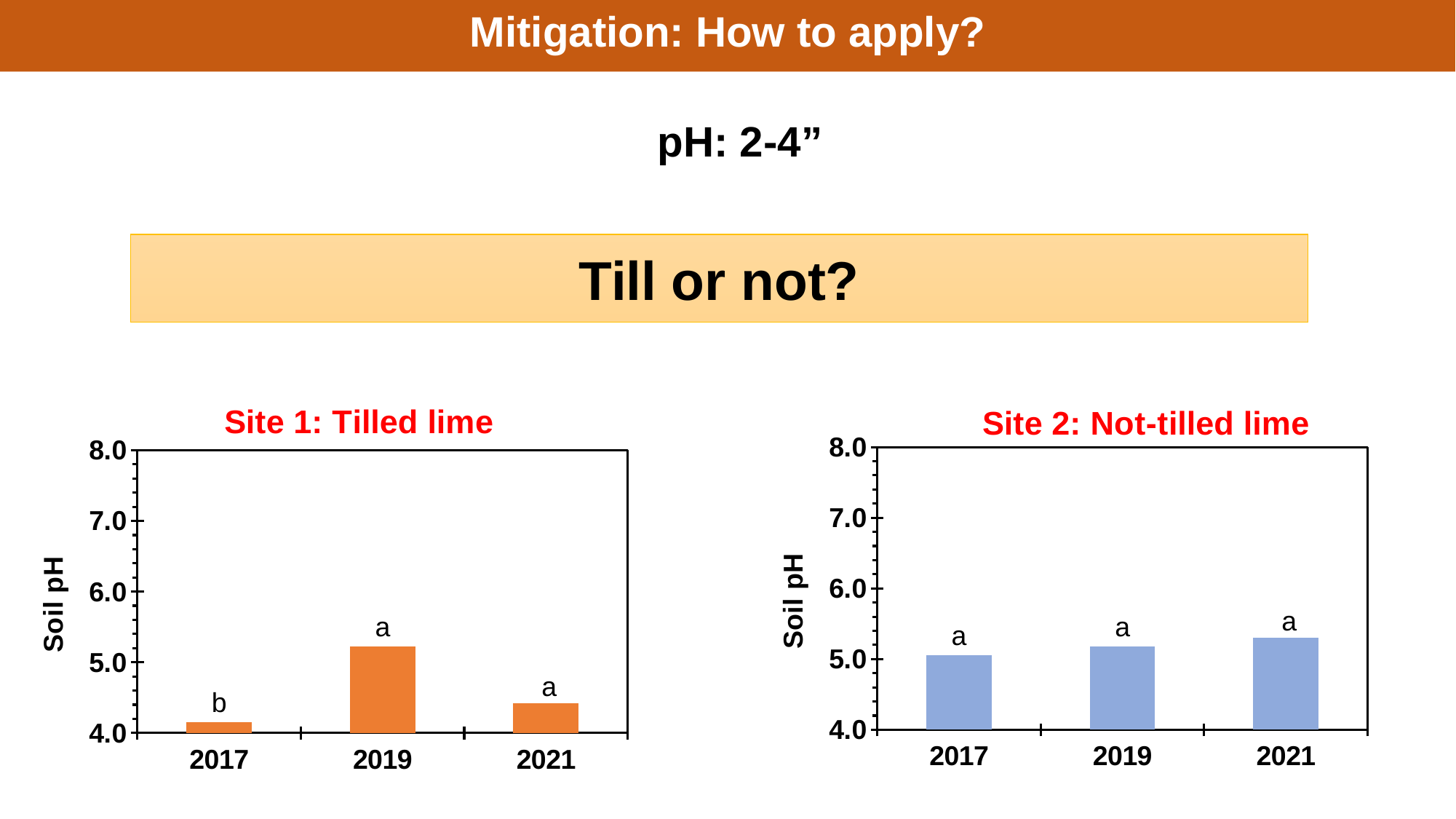
In the "Site 1: Tilled lime" chart, which year has the lowest soil pH? 2017 In the "Site 1: Tilled lime" chart, is the soil pH for 2021 greater or less than 5.0? less What letter is printed above the 2017 bar in the "Site 1: Tilled lime" chart? b In the "Site 1: Tilled lime" chart, which year has the larger soil pH, 2017 or 2021? 2021 How many years are shown on the x axis of the "Site 2: Not-tilled lime" chart? 3 In the "Site 1: Tilled lime" chart, which year has the highest soil pH? 2019 In the "Site 2: Not-tilled lime" chart, is the soil pH for 2021 greater or less than 6.0? less What kind of chart is "Site 1: Tilled lime"? bar chart In the "Site 2: Not-tilled lime" chart, which year has the lowest soil pH? 2017 What is the y-axis label on the "Site 1: Tilled lime" chart? Soil pH In the "Site 2: Not-tilled lime" chart, do the soil pH values rise or fall from 2017 to 2021? rise In the "Site 1: Tilled lime" chart, is the soil pH for 2019 greater or less than 5.0? greater